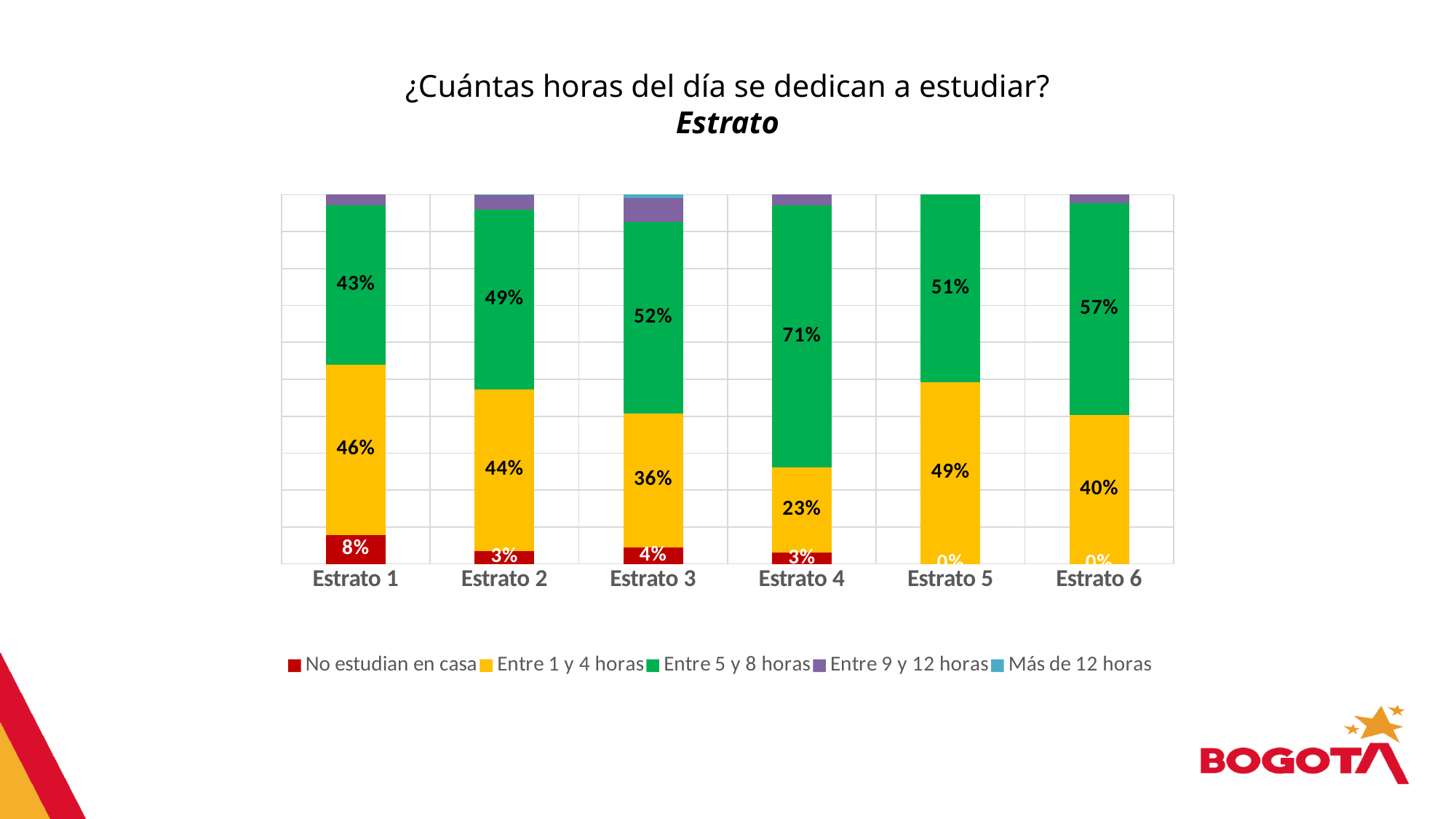
How many estrato categories are shown on the x axis? 6 How many series does the legend list? 5 Which series is shown in green in the legend? Entre 5 y 8 horas Which estrato has the lowest value for 'Entre 1 y 4 horas'? Estrato 4 What is the value for 'No estudian en casa' in Estrato 3? 4% What is the value for 'Entre 5 y 8 horas' in Estrato 4? 71% Which estrato has the highest value for 'No estudian en casa'? Estrato 1 Which estrato has the highest value for 'Entre 5 y 8 horas'? Estrato 4 What is the difference between the 'Entre 5 y 8 horas' values for Estrato 6 and Estrato 1? 14% What type of chart is shown on the slide? Stacked bar chart Which is larger: the 'Entre 1 y 4 horas' value for Estrato 5 or for Estrato 6? Estrato 5 What is the value for 'Entre 1 y 4 horas' in Estrato 1? 46%